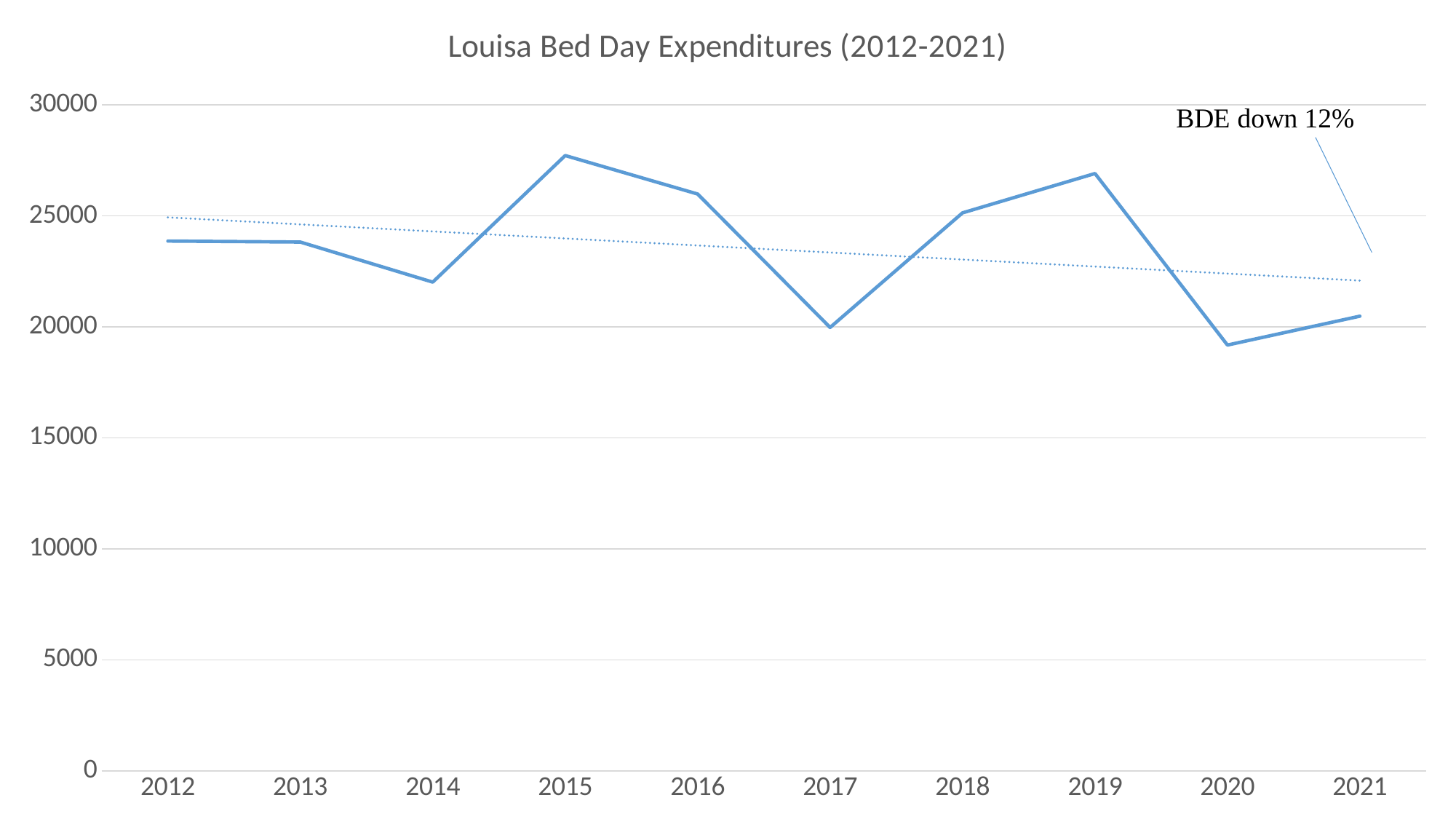
Is the value for 2012 greater or less than 25000? less Which is larger, the value for 2017 or the value for 2015? 2015 Is the value for 2020 greater or less than 20000? less What is the title of the chart? Louisa Bed Day Expenditures (2012-2021) Is the value for 2014 greater or less than 20000? greater What kind of chart is shown on the slide? line chart According to the dotted trend line, do the values generally rise or fall from 2012 to 2021? fall Which is larger, the value for 2019 or the value for 2020? 2019 Which year has the highest bed day expenditure? 2015 How many years are plotted on the x axis? 10 Which year has the lowest bed day expenditure? 2020